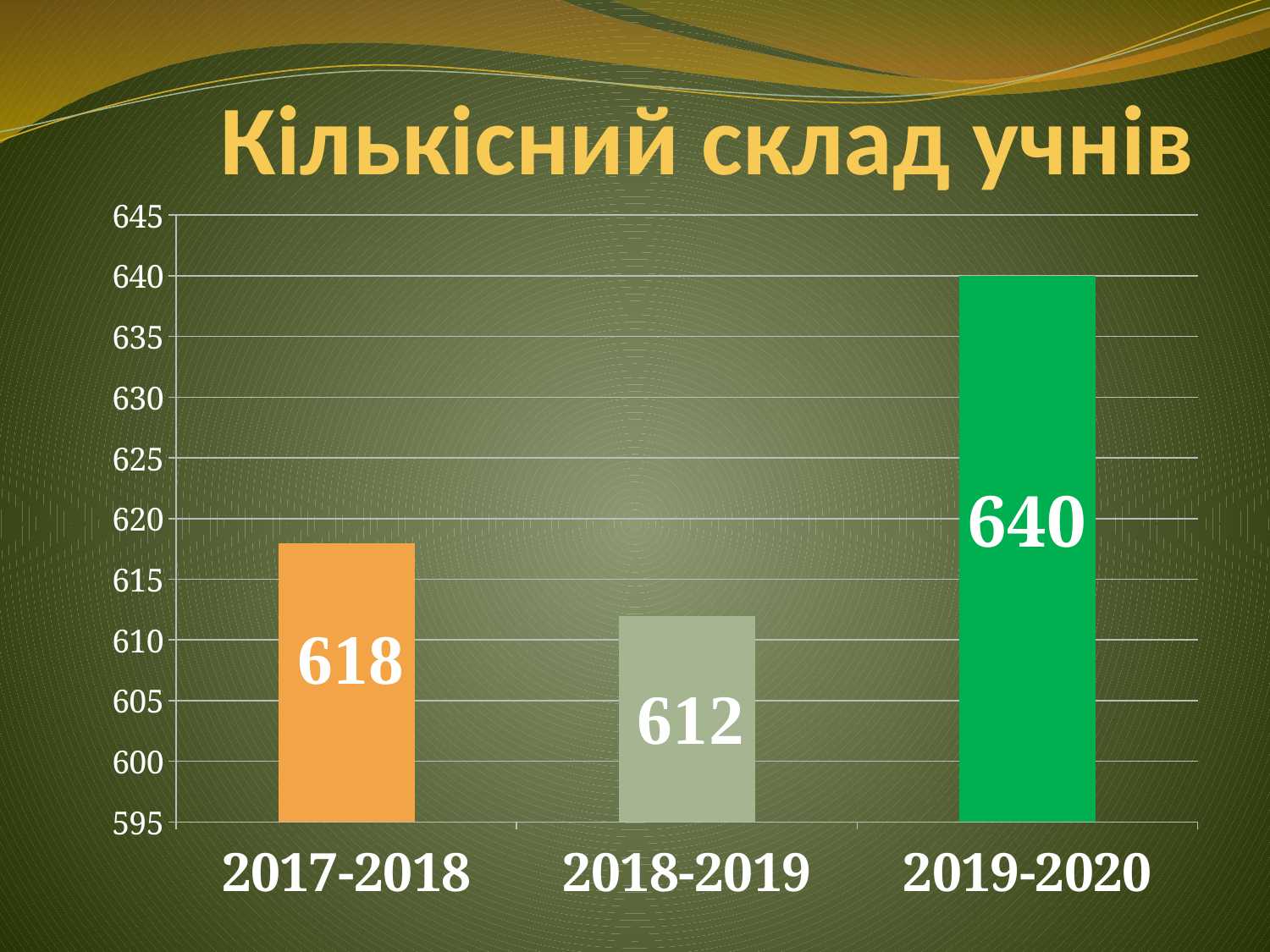
How many school years are shown on the chart? 3 What is the difference between the values for 2019-2020 and 2018-2019? 28 What is the value for 2019-2020? 640 Which school year has the lowest value? 2018-2019 Which is larger, the value for 2017-2018 or the value for 2018-2019? 2017-2018 Which school year has the highest value? 2019-2020 What is the difference between the values for 2017-2018 and 2018-2019? 6 Is the value for 2019-2020 greater or less than 630? greater What is the title of the chart? Кількісний склад учнів What is the value for 2017-2018? 618 What kind of chart is shown on the slide? bar chart What is the value for 2018-2019? 612